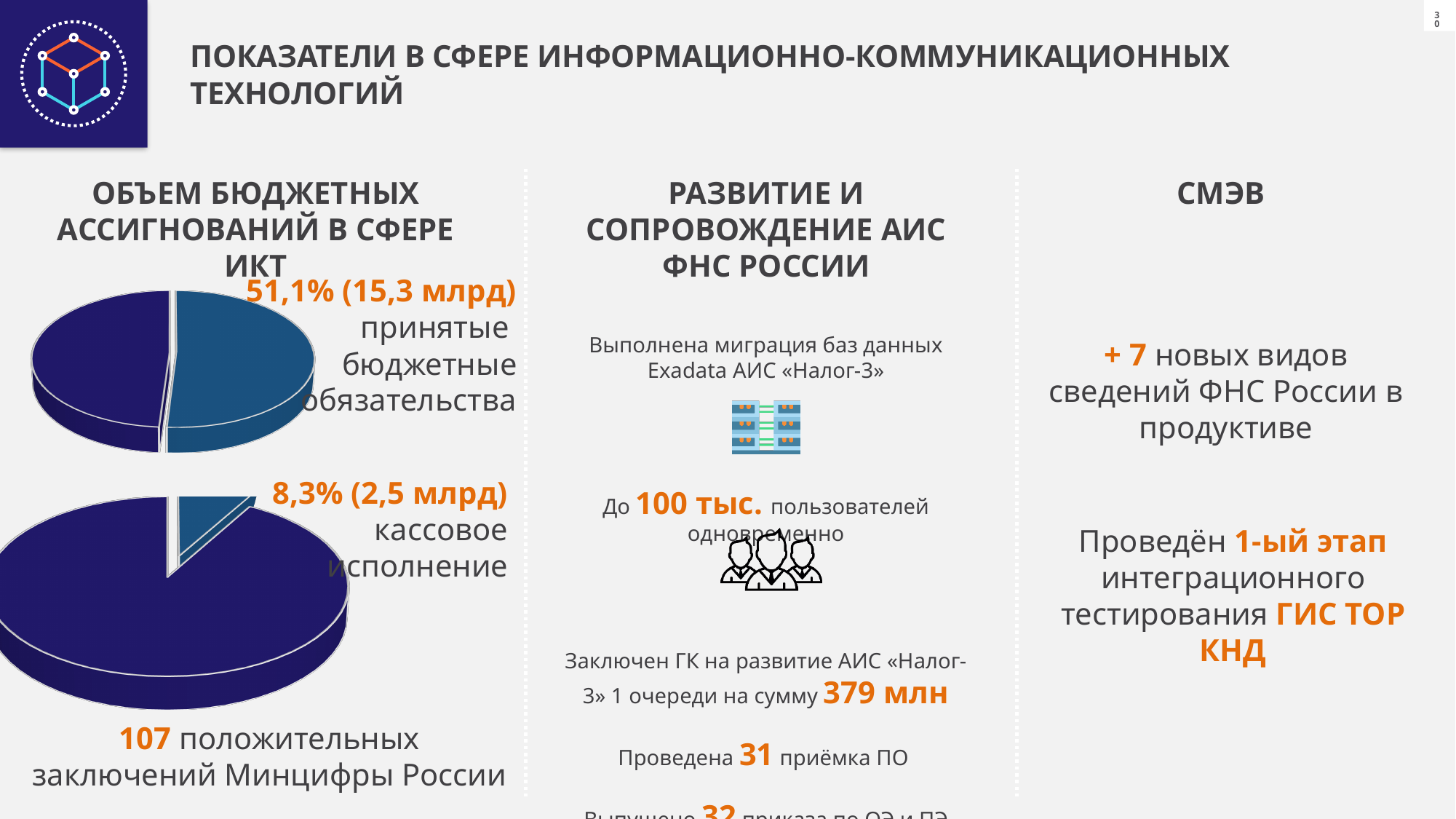
How many slices does the bottom pie chart have? 2 In the bottom pie chart, what amount in billions is shown for кассовое исполнение? 2,5 млрд In the bottom pie chart, what share is labelled for кассовое исполнение? 8,3% In the bottom pie chart, is the share for кассовое исполнение greater or less than 10%? Less What kind of chart is the top chart on the left side of the slide? Pie chart In the top pie chart, what amount in billions is shown for принятые бюджетные обязательства? 15,3 млрд How many slices does the top pie chart have? 2 What is the heading above the two pie charts on the left of the slide? ОБЪЕМ БЮДЖЕТНЫХ АССИГНОВАНИЙ В СФЕРЕ ИКТ What kind of chart is the bottom chart on the left side of the slide? Pie chart In the bottom pie chart, which slice is dark navy: the кассовое исполнение slice or the remaining slice? The remaining slice In the bottom pie chart, is the кассовое исполнение slice larger or smaller than the remaining slice? Smaller In the top pie chart, what share is labelled for принятые бюджетные обязательства? 51,1%